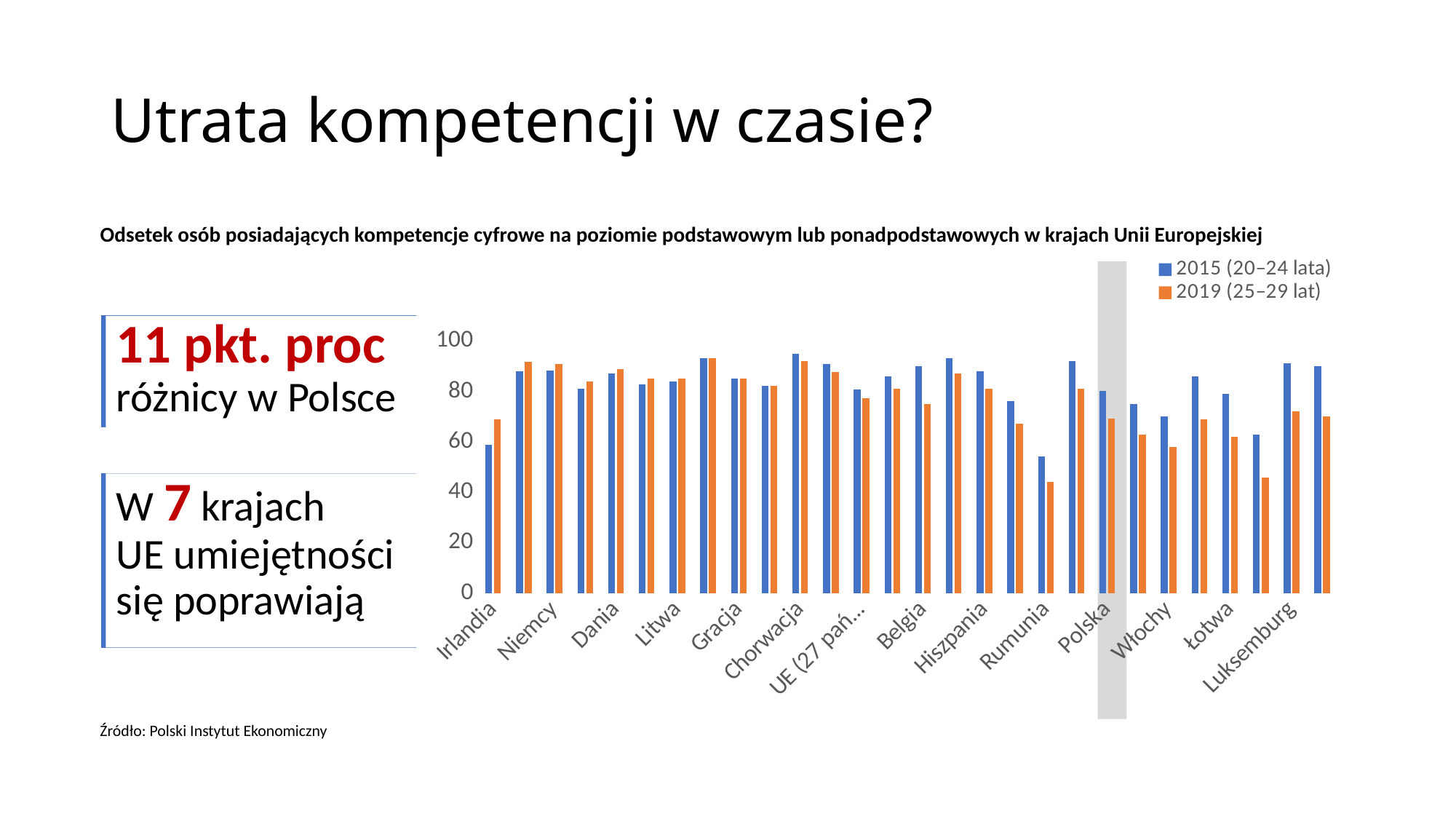
Which series is shown in orange in the chart? 2019 (25–29 lat) Is the 2019 (25–29 lat) value for Niemcy greater or less than 80? greater Which country is highlighted with a grey band in the chart? Polska For Irlandia, which series has the larger value: 2015 (20–24 lata) or 2019 (25–29 lat)? 2019 (25–29 lat) Is the 2019 (25–29 lat) value for Irlandia greater or less than 80? less Is the 2015 (20–24 lata) value for Luksemburg greater or less than 80? greater For Rumunia, which series has the larger value: 2015 (20–24 lata) or 2019 (25–29 lat)? 2015 (20–24 lata) How many series does the chart legend list? 2 For Luksemburg, which series has the larger value: 2015 (20–24 lata) or 2019 (25–29 lat)? 2015 (20–24 lata) What kind of chart is shown on the slide? bar chart